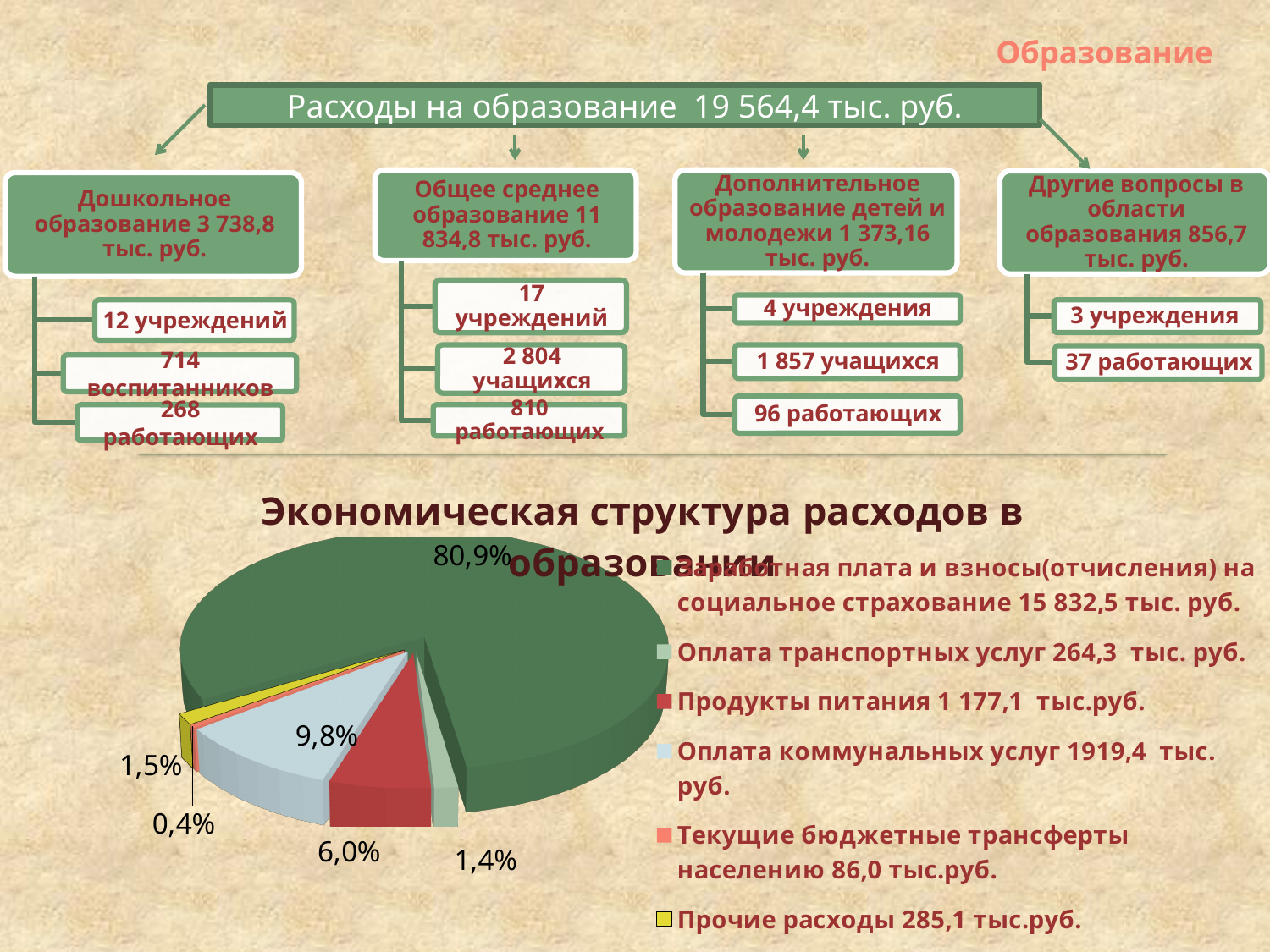
Which category has the smallest slice in the pie chart? Текущие бюджетные трансферты населению In the pie chart, what share is shown for "Оплата коммунальных услуг"? 9,8% Which category has the largest slice in the pie chart "Экономическая структура расходов в образовании"? Заработная плата и взносы(отчисления) на социальное страхование In the pie chart, which is larger: the share for "Оплата коммунальных услуг" or for "Продукты питания"? Оплата коммунальных услуг In the pie chart, what share is shown for "Оплата транспортных услуг"? 1,4% In the pie chart "Экономическая структура расходов в образовании", what share is shown for "Заработная плата и взносы(отчисления) на социальное страхование"? 80,9% In the pie chart, what share is shown for "Текущие бюджетные трансферты населению"? 0,4% In the pie chart, what share is shown for "Продукты питания"? 6,0% In the pie chart, what is the difference in percentage points between the shares for "Оплата коммунальных услуг" and "Продукты питания"? 3,8 How many categories does the legend of the pie chart list? 6 What kind of chart is shown under the title "Экономическая структура расходов в образовании"? pie chart In the pie chart, what share is shown for "Прочие расходы"? 1,5%